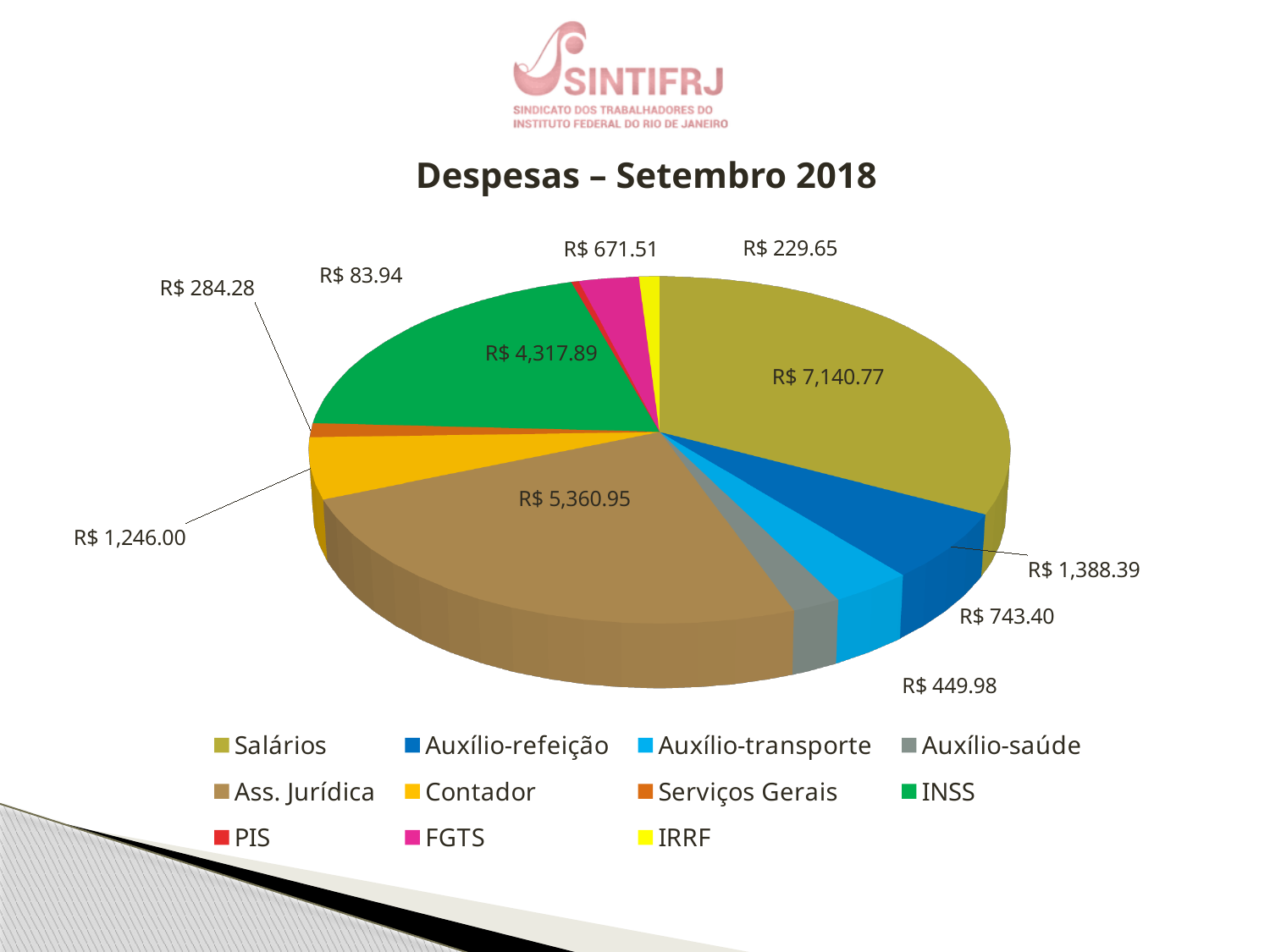
What is the value for Ass. Jurídica? R$ 5,360.95 What kind of chart is shown on the slide? Pie chart Which is larger, Auxílio-refeição or Auxílio-transporte? Auxílio-refeição What is the value for Contador? R$ 1,246.00 Which category has the smallest slice? PIS What is the value for PIS? R$ 83.94 What is the value for Salários? R$ 7,140.77 How many categories does the legend list? 11 What is the difference between Salários and Ass. Jurídica? R$ 1,779.82 What is the value for INSS? R$ 4,317.89 Which category has the largest slice? Salários What is the title of the chart? Despesas – Setembro 2018